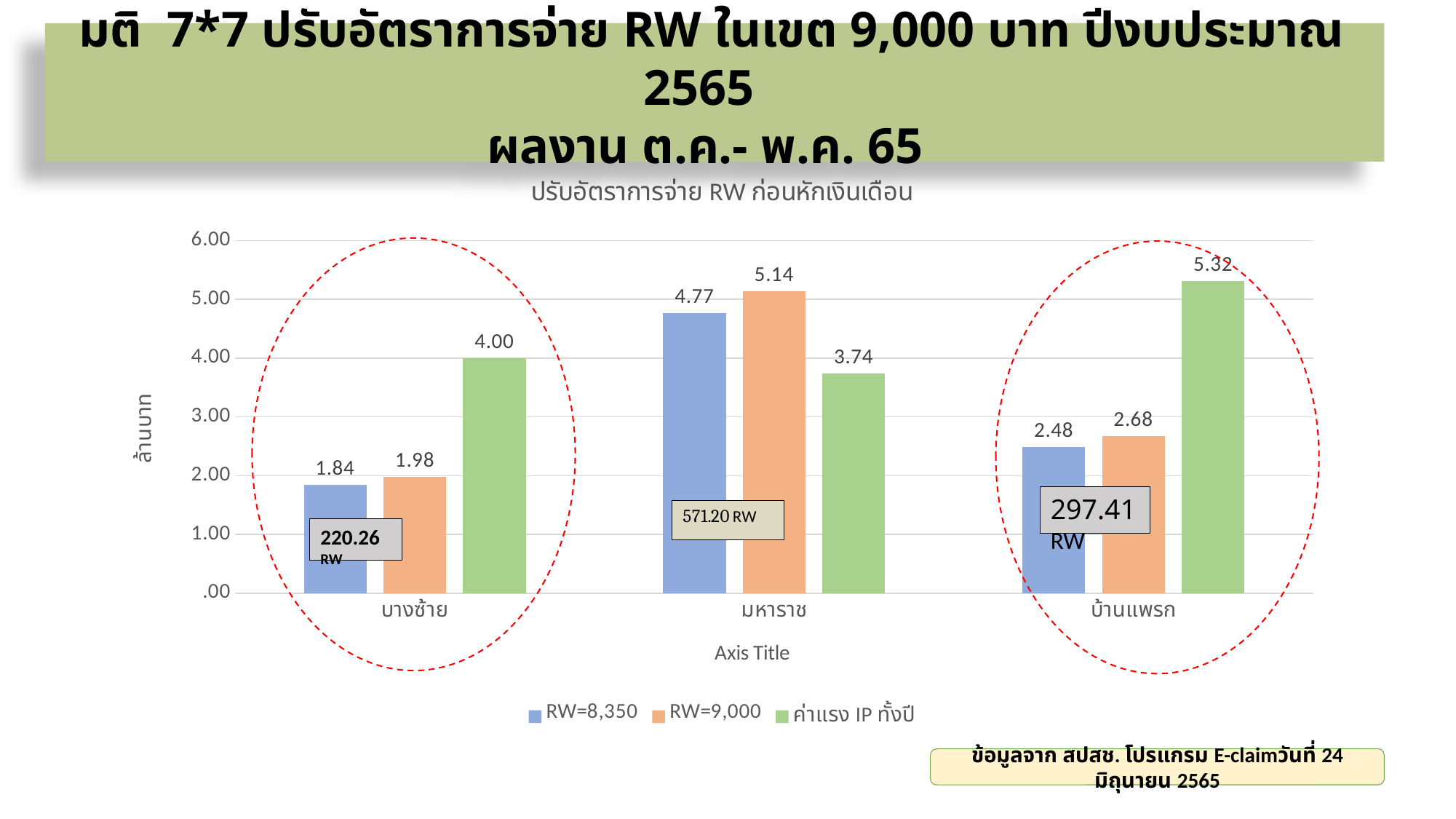
Which category has the lowest value for the ค่าแรง IP ทั้งปี series? มหาราช What is the difference between the RW=9,000 and RW=8,350 values for บ้านแพรก? 0.20 Which category has the highest value for the RW=8,350 series? มหาราช What is the value for RW=9,000 in the มหาราช category? 5.14 Which is larger for มหาราช: the RW=9,000 value or the ค่าแรง IP ทั้งปี value? RW=9,000 How many series does the legend list? 3 What is the value for ค่าแรง IP ทั้งปี in the บ้านแพรก category? 5.32 What is the title of the chart? ปรับอัตราการจ่าย RW ก่อนหักเงินเดือน What kind of chart is shown on the slide? bar chart How many categories are shown on the x axis? 3 Is the value for ค่าแรง IP ทั้งปี in บางซ้าย greater or less than 3.00? greater What is the value for RW=8,350 in the บางซ้าย category? 1.84